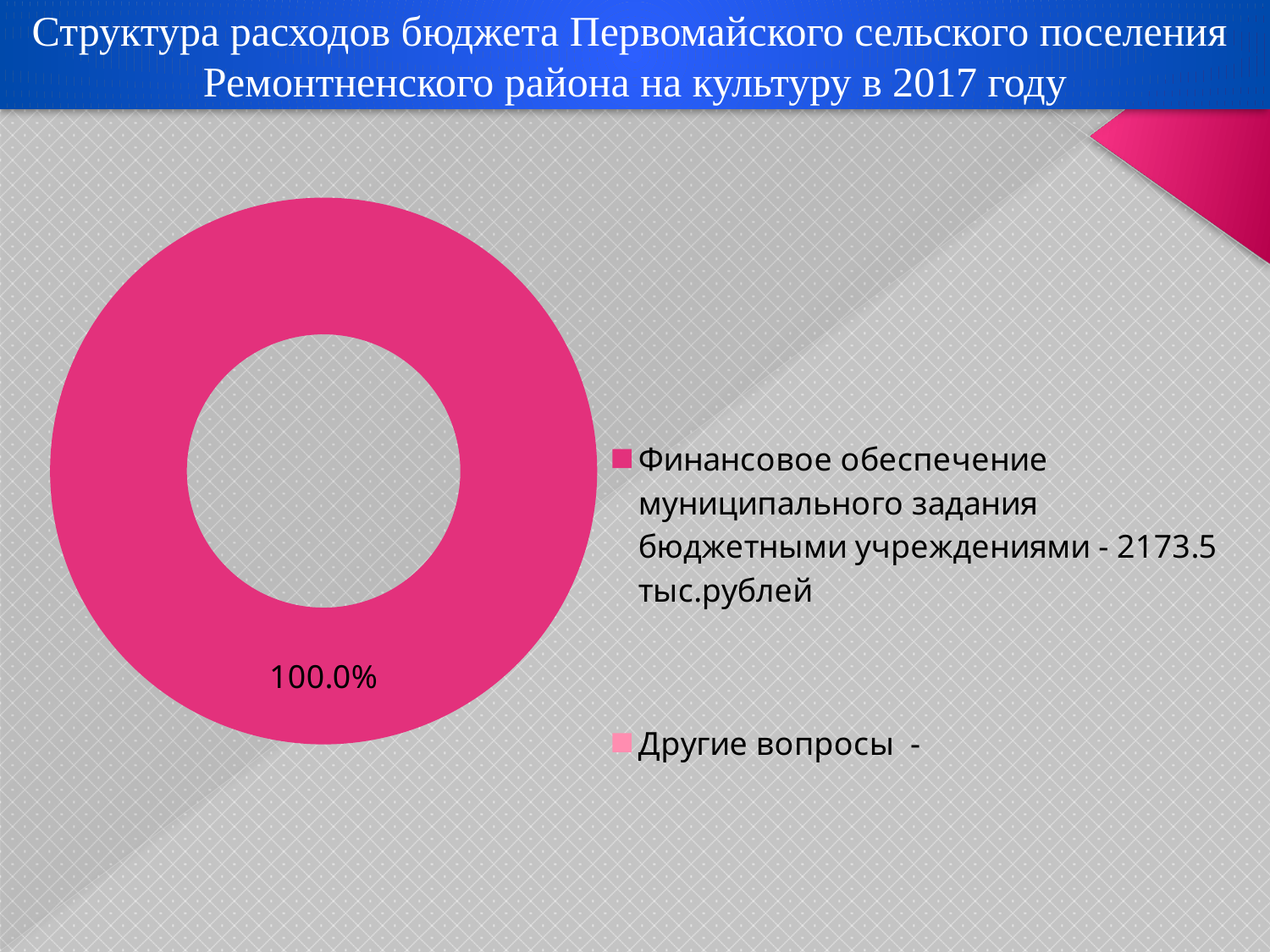
Which category accounts for the largest share of the chart? Финансовое обеспечение муниципального задания бюджетными учреждениями What kind of chart is shown on the slide? Doughnut (pie) chart What is the second legend entry on the slide? Другие вопросы - What amount is given in the legend for "Финансовое обеспечение муниципального задания бюджетными учреждениями"? 2173.5 тыс.рублей What percentage label is printed on the chart? 100.0% What year does the chart title refer to? 2017 How many entries does the legend list? 2 What share of the chart does the slice for "Финансовое обеспечение муниципального задания бюджетными учреждениями" take? 100.0%